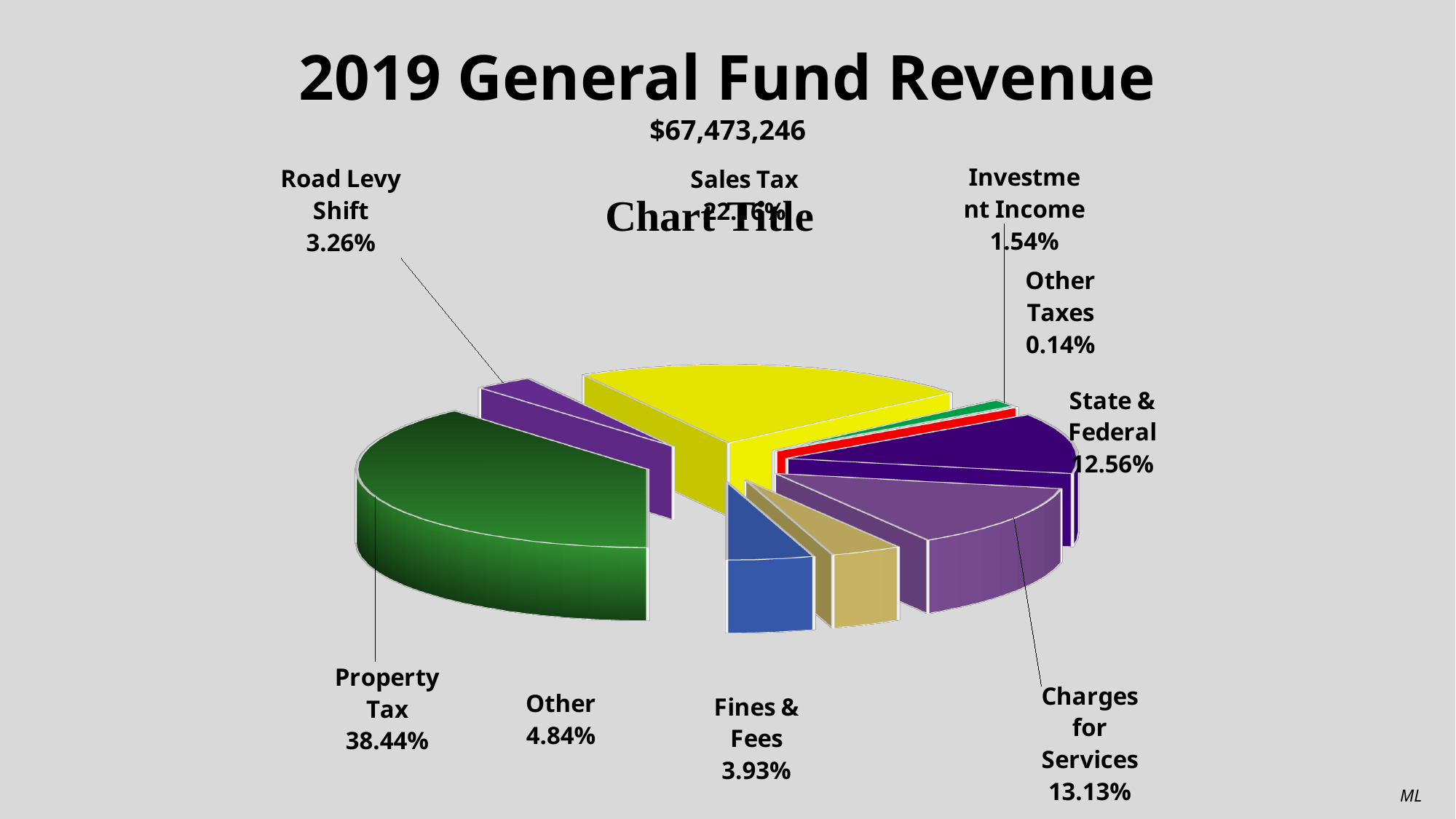
What kind of chart is shown on the slide? pie chart What is the difference in percentage points between Charges for Services and State & Federal? 0.57% What total revenue amount is shown beneath the slide title? $67,473,246 What share of 2019 General Fund Revenue comes from Property Tax? 38.44% What share does Investment Income represent? 1.54% Which revenue category has the largest share of the pie? Property Tax Which is larger, the share for Other or the share for Road Levy Shift? Other How many revenue categories are shown in the pie chart? 9 What percentage of revenue is State & Federal? 12.56% What percentage of revenue is Charges for Services? 13.13% Which revenue category has the smallest share of the pie? Other Taxes What percentage is shown for Fines & Fees? 3.93%